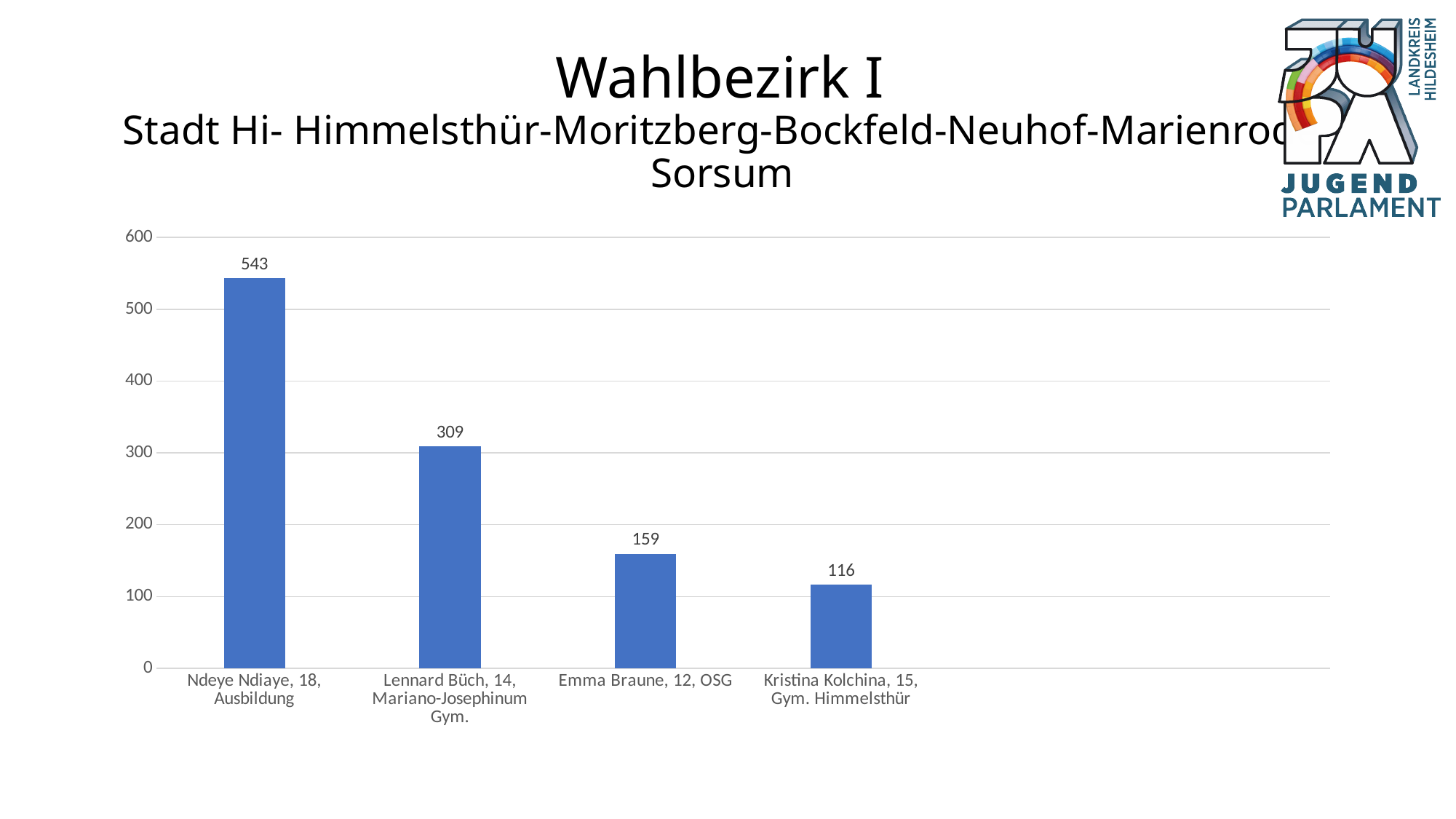
Which candidate has the highest value? Ndeye Ndiaye, 18, Ausbildung What is the difference between the values for Emma Braune and Kristina Kolchina? 43 What is the difference between the values for Ndeye Ndiaye and Lennard Büch? 234 What value is shown for Emma Braune, 12, OSG? 159 What value is shown for Kristina Kolchina, 15, Gym. Himmelsthür? 116 Do the values rise or fall from left to right across the chart? Fall What kind of chart is shown on the slide? Bar chart How many candidates are shown in the chart? 4 What value is shown for Ndeye Ndiaye, 18, Ausbildung? 543 Which is larger, the value for Lennard Büch or the value for Emma Braune? Lennard Büch What value is shown for Lennard Büch, 14, Mariano-Josephinum Gym.? 309 Which candidate has the lowest value? Kristina Kolchina, 15, Gym. Himmelsthür